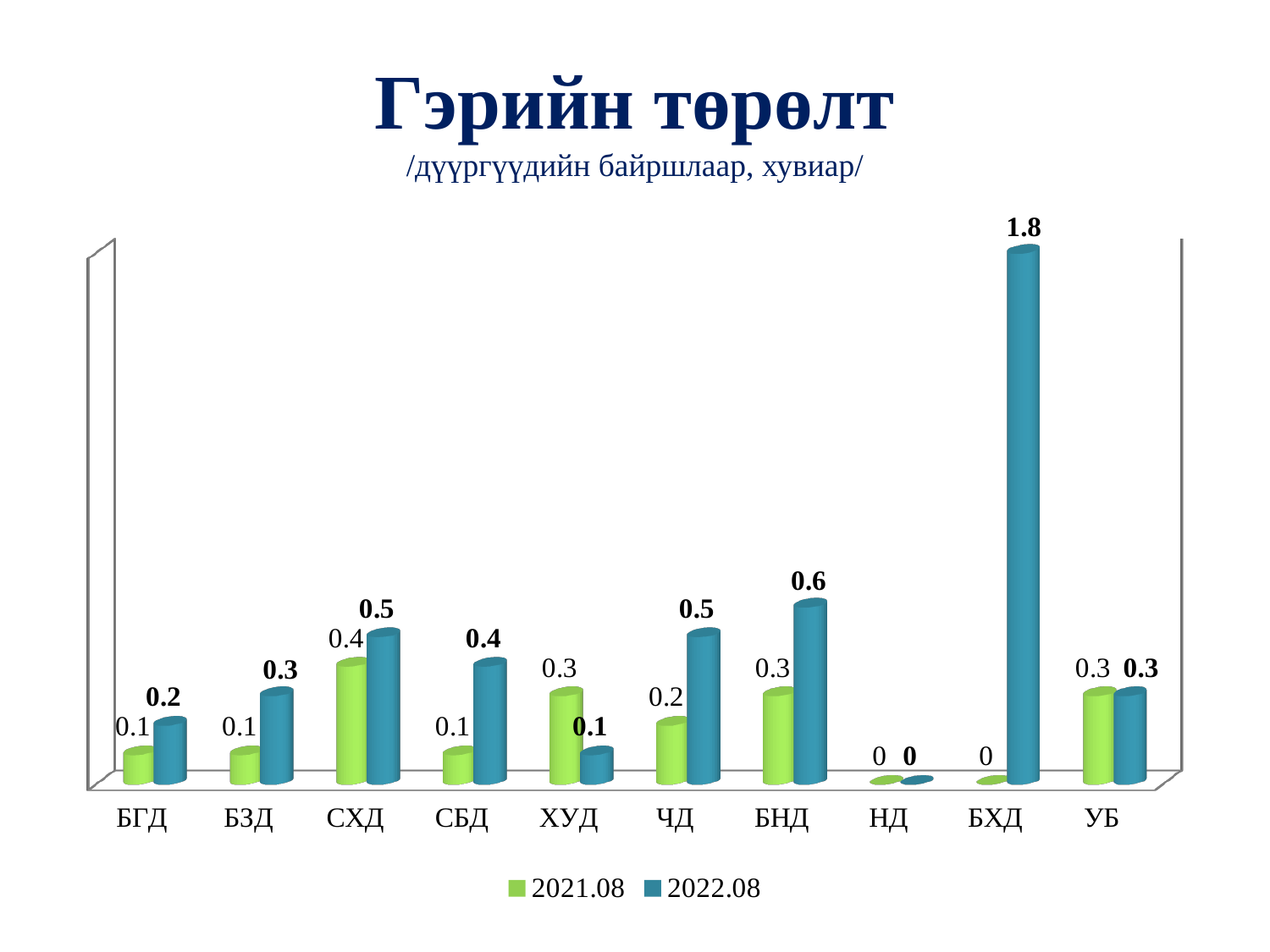
What kind of chart is shown on the slide? Bar chart What is the value for БНД in the 2022.08 series? 0.6 What is the difference between the 2022.08 and 2021.08 values for БХД? 1.8 What is the difference between the 2022.08 and 2021.08 values for ЧД? 0.3 How many categories are shown on the x axis? 10 What is the value for БХД in the 2022.08 series? 1.8 Which category has the highest value in the 2022.08 series? БХД What is the value for СХД in the 2021.08 series? 0.4 How many series does the legend list? 2 What is the title of the chart? Гэрийн төрөлт Which category has the highest value in the 2021.08 series? СХД For ХУД, which series has the larger value, 2021.08 or 2022.08? 2021.08